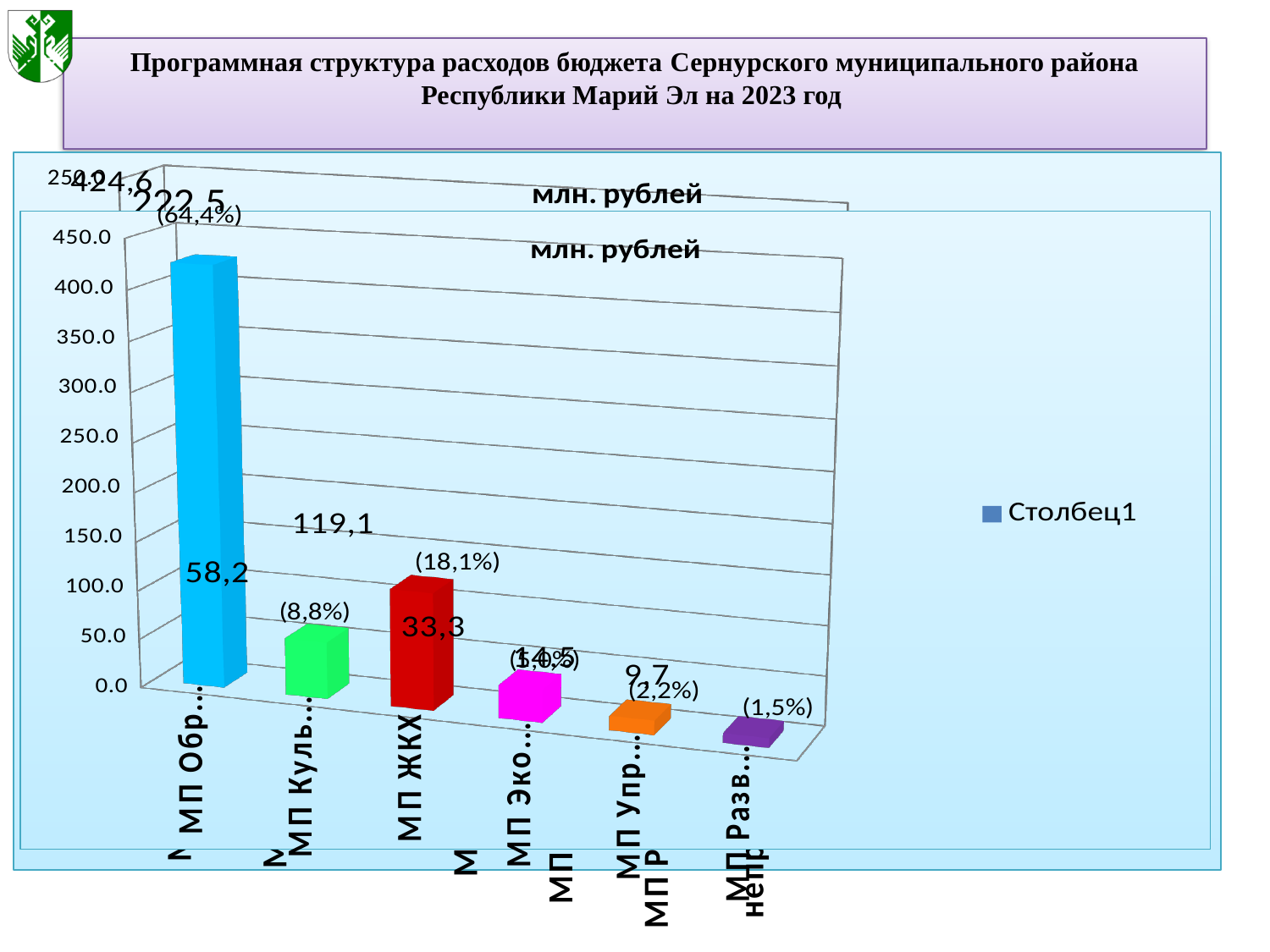
What kind of chart is shown on the slide? bar chart How many series does the chart legend list? 1 What percentage share is labelled above the red bar (МП ЖКХ)? (18,1%) What unit is given in the chart title? млн. рублей How many bars are plotted in the chart? 6 What is the legend entry shown to the right of the chart? Столбец1 Is the value of the first (blue) bar greater or less than 300? greater Is the value of the last (purple) bar greater or less than 50? less Which bar is the shortest in the chart? the last (purple) bar, МП Разв... Which is larger, the red bar (МП ЖКХ) or the green bar next to it? the red bar (МП ЖКХ) Which bar is the tallest in the chart? the first (blue) bar, МП Обр...